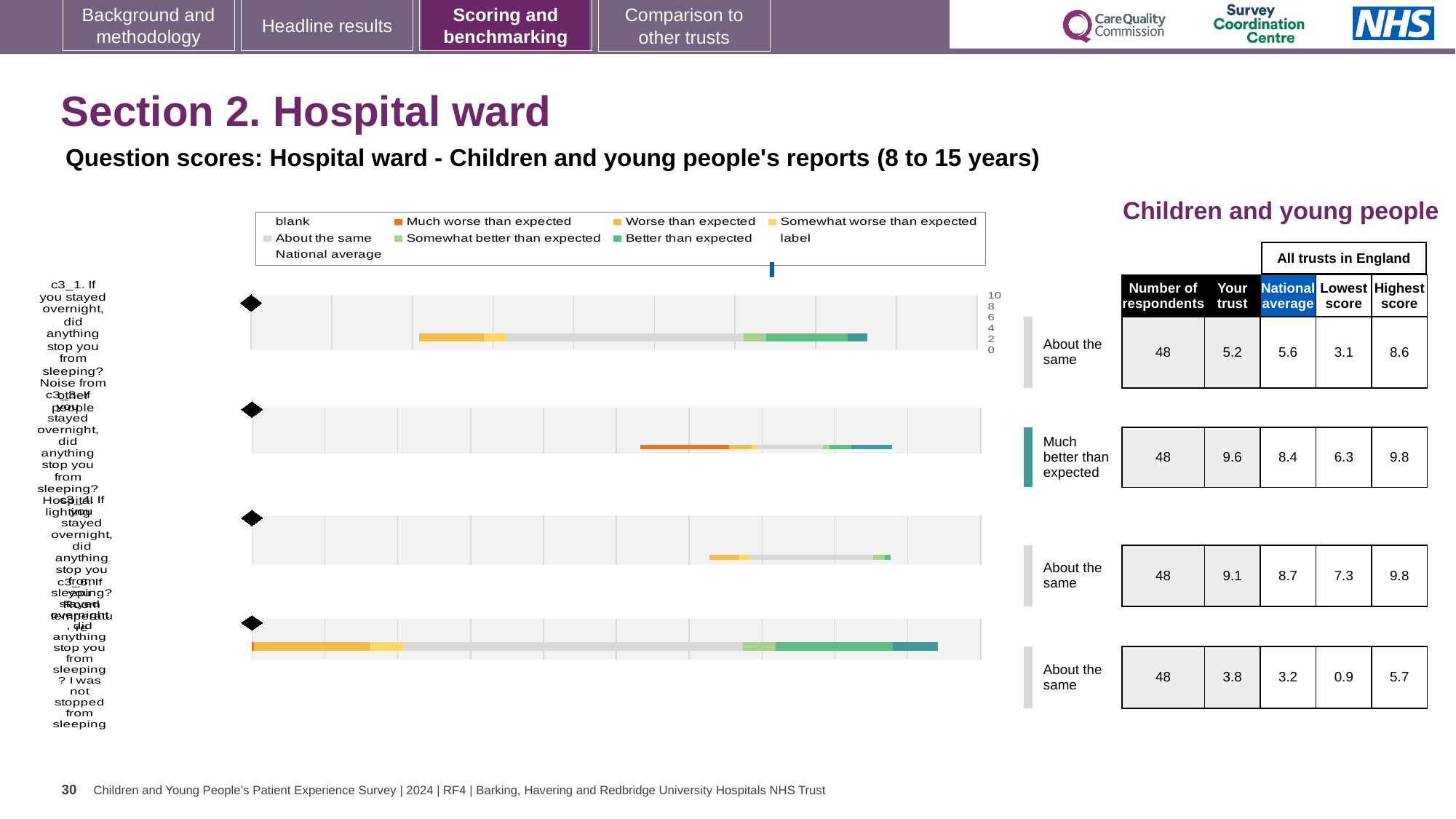
What is the difference between the 'Your trust' score and the national average for the second row (c3_3)? 1.2 In the chart legend, what colour represents 'About the same'? grey Which benchmark category is the second row (c3_3) placed in? Much better than expected How many horizontal bars (question rows) does the chart contain? 4 What is the highest score across all trusts in England for the third row (c3_4)? 9.8 What is the national average for the fourth row (c3_6, I was not stopped from sleeping)? 3.2 What is the 'Your trust' score for the second row (c3_3, hospital lighting)? 9.6 Which row has the lowest 'Your trust' score? c3_6 (fourth row), 3.8 What is the 'Your trust' score for the first row (c3_1, noise from other people)? 5.2 What kind of chart is shown on the slide? bar chart In the chart legend, what colour represents 'Much worse than expected'? orange Which row has the highest 'Your trust' score? c3_3 (second row), 9.6